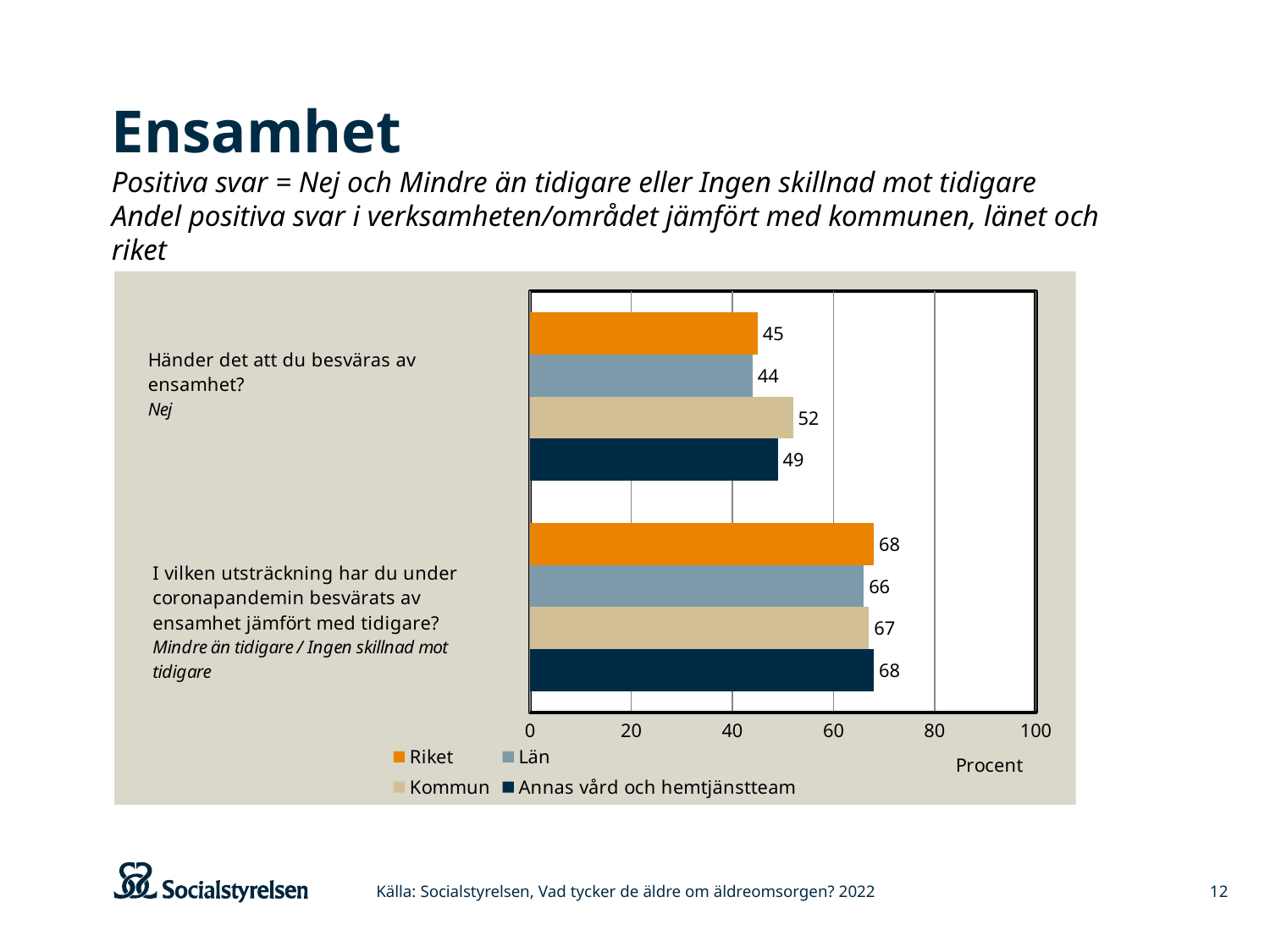
Which series has the highest value for the question "Händer det att du besväras av ensamhet?"? Kommun How many series does the legend list? 4 What is the value for Riket for the question "I vilken utsträckning har du under coronapandemin besvärats av ensamhet jämfört med tidigare?"? 68 What is the value for Annas vård och hemtjänstteam for the question "Händer det att du besväras av ensamhet?"? 49 What kind of chart is shown on the slide? Bar chart Which series has the lowest value for the question "I vilken utsträckning har du under coronapandemin besvärats av ensamhet jämfört med tidigare?"? Län What is the difference between the Kommun value and the Län value for the question "Händer det att du besväras av ensamhet?"? 8 What is the value for Län for the question "Händer det att du besväras av ensamhet?"? 44 Is the value for Riket for the question "Händer det att du besväras av ensamhet?" greater or less than 60? less What is the value for Kommun for the question "Händer det att du besväras av ensamhet?"? 52 For Annas vård och hemtjänstteam, which question has the larger value: "Händer det att du besväras av ensamhet?" or "I vilken utsträckning har du under coronapandemin besvärats av ensamhet jämfört med tidigare?"? I vilken utsträckning har du under coronapandemin besvärats av ensamhet jämfört med tidigare? What is the label of the horizontal axis? Procent